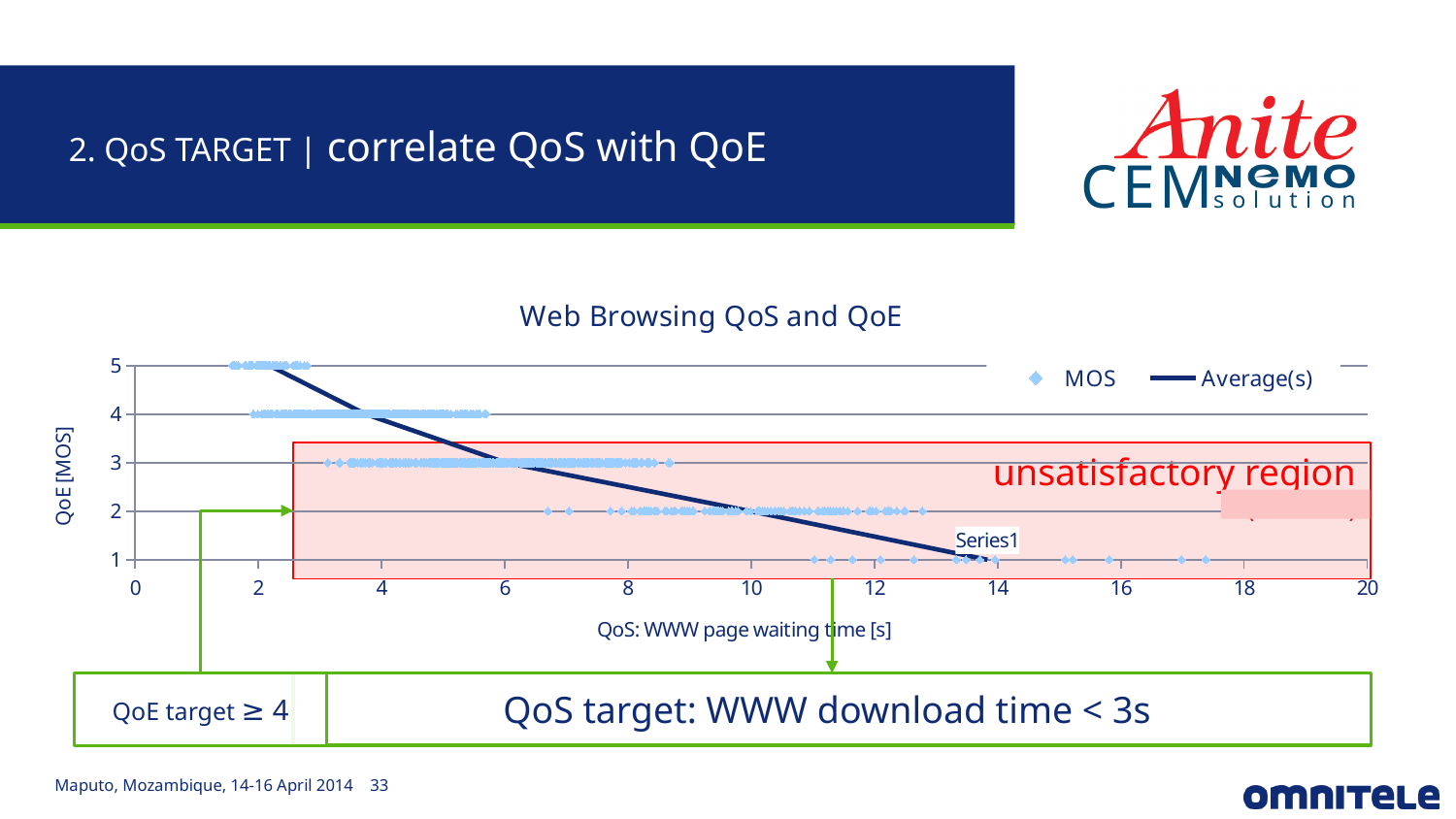
What kind of chart is shown on the slide? scatter chart Is the Average(s) value at a waiting time of 12 s greater or less than 2? less Is the Average(s) value at a waiting time of 4 s greater or less than 3? greater What is the title of the chart? Web Browsing QoS and QoE What is the highest value shown on the x axis of the chart? 20 What is the highest value shown on the y axis of the chart? 5 What are the two entries in the chart's legend? MOS and Average(s) Which is larger: the Average(s) value at 2 s or at 14 s? at 2 s Does the Average(s) line rise or fall as the WWW page waiting time increases? falls How many series does the legend of the chart list? 2 Is the Average(s) value at a waiting time of 8 s greater or less than 3? less